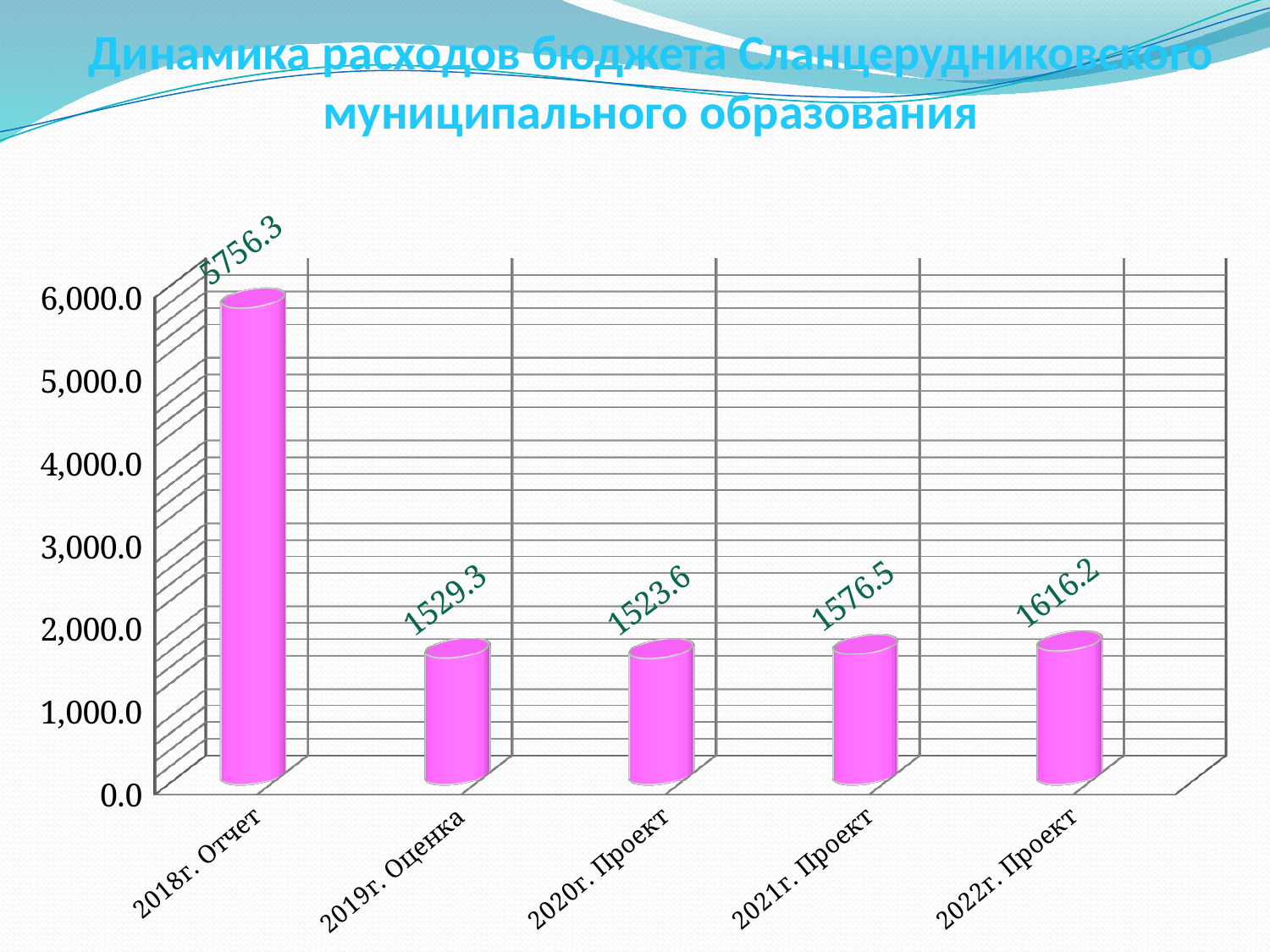
Is the value for 2018г. Отчет greater or less than 5,000.0? greater How many categories are shown on the x axis? 5 Which category has the lowest value? 2020г. Проект What kind of chart is shown on the slide? bar chart What is the value for 2020г. Проект? 1523.6 What is the difference between the values for 2022г. Проект and 2021г. Проект? 39.7 What is the value for 2018г. Отчет? 5756.3 What is the value for 2022г. Проект? 1616.2 What is the value for 2019г. Оценка? 1529.3 What is the difference between the values for 2018г. Отчет and 2019г. Оценка? 4227.0 Which is larger, the value for 2021г. Проект or the value for 2020г. Проект? 2021г. Проект Which category has the highest value? 2018г. Отчет